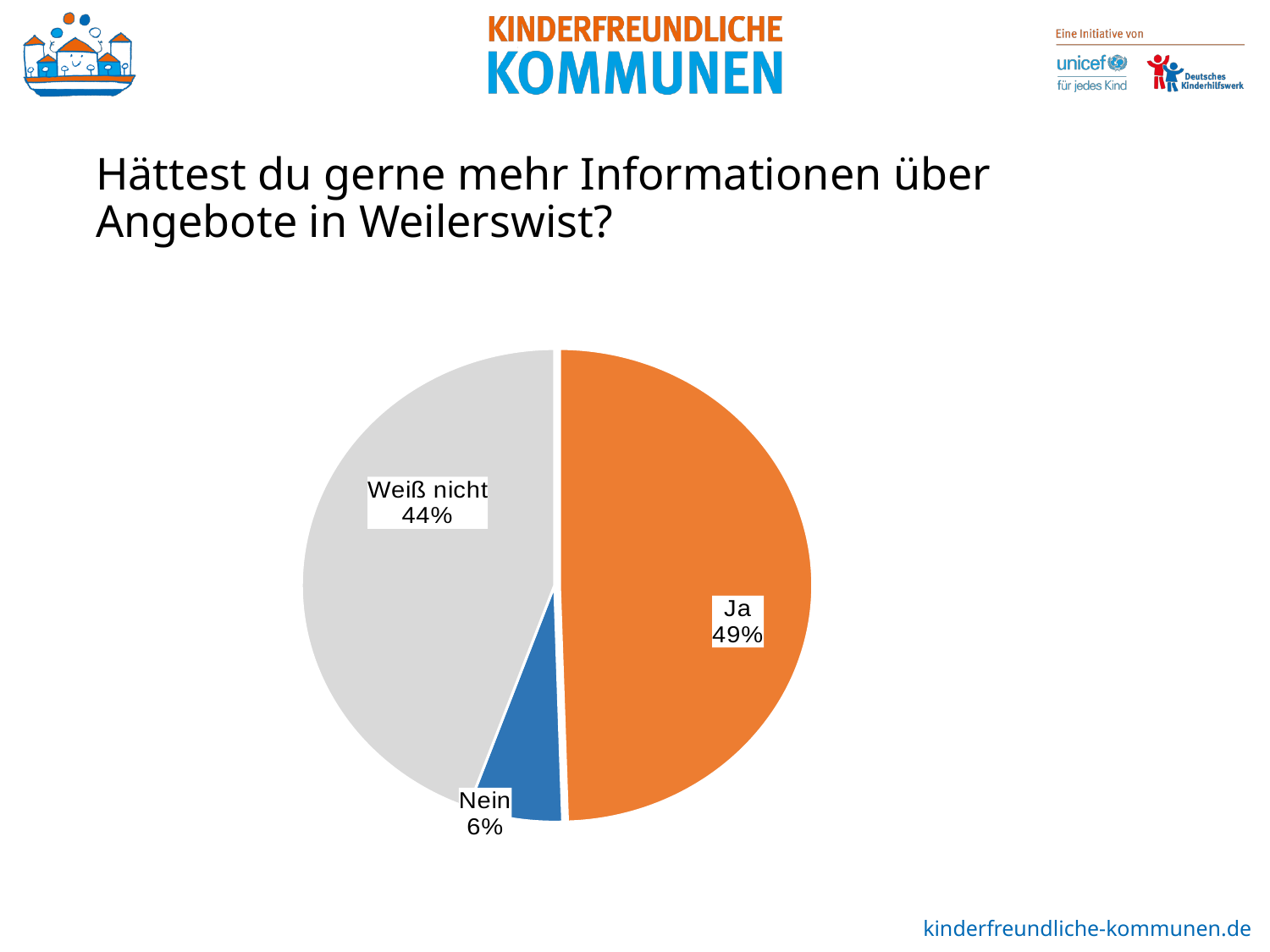
What kind of chart is shown on the slide? pie chart Which answer has the smallest share of the pie? Nein Which is larger, the share for "Nein" or the share for "Weiß nicht"? Weiß nicht What is the difference in percentage points between "Weiß nicht" and "Nein"? 38 What share of respondents answered "Nein"? 6% What share of respondents answered "Ja"? 49% What is the difference in percentage points between "Ja" and "Weiß nicht"? 5 How many slices does the pie chart have? 3 What colour is the "Ja" slice of the pie? orange What share of respondents answered "Weiß nicht"? 44% Which answer has the largest share of the pie? Ja What question does the chart on the slide answer? Hättest du gerne mehr Informationen über Angebote in Weilerswist?